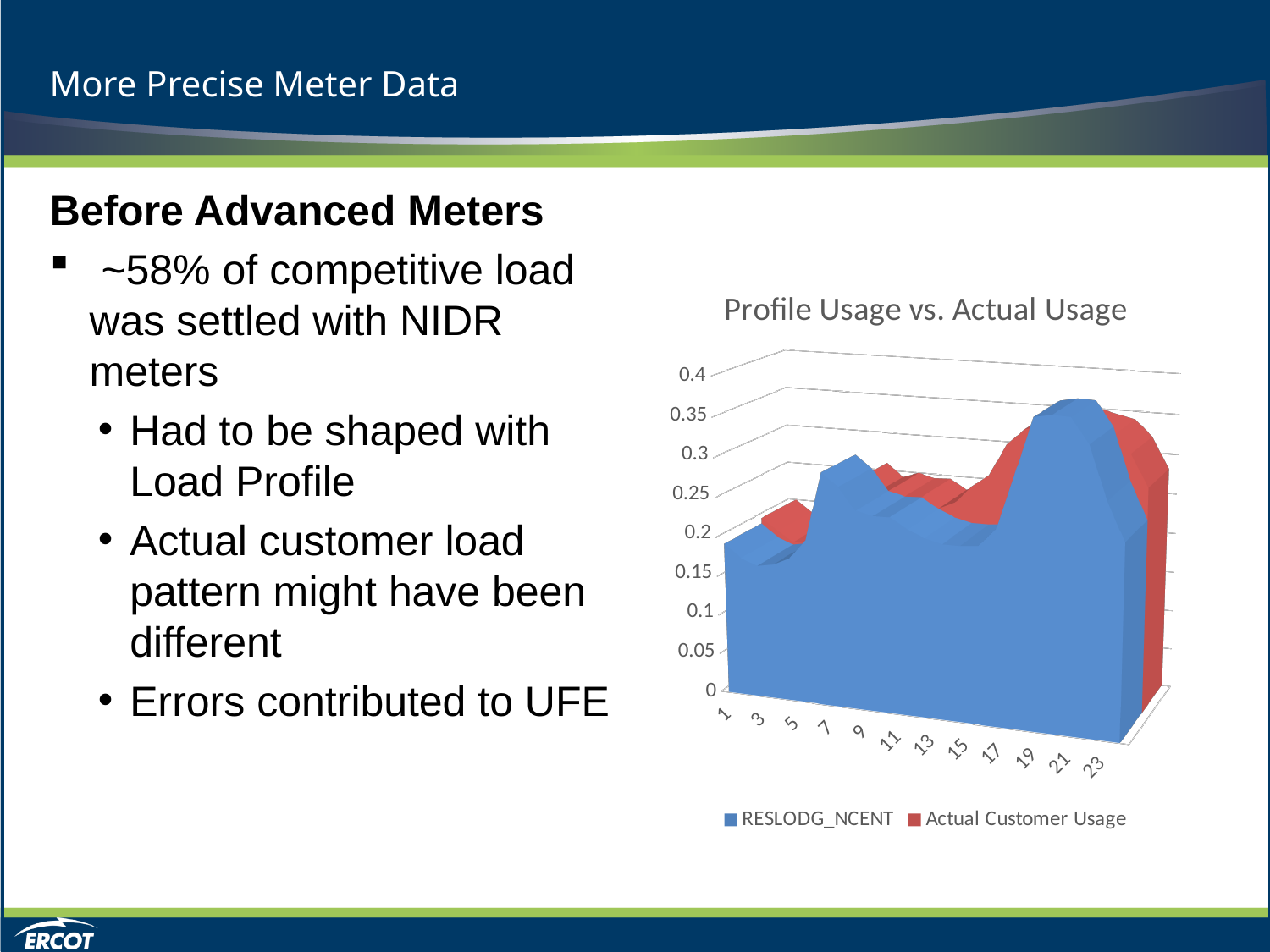
What is the highest value shown on the chart's vertical axis? 0.4 How many labels are printed along the chart's horizontal axis? 12 What are the two series named in the chart legend? RESLODG_NCENT and Actual Customer Usage Is the value for RESLODG_NCENT at hour 1 greater or less than 0.4? less Which series is drawn in blue on the chart? RESLODG_NCENT What is the lowest value shown on the chart's vertical axis? 0 What is the title of the chart on the slide? Profile Usage vs. Actual Usage What kind of chart is shown on the slide? 3D area chart How many series does the chart's legend list? 2 Does the RESLODG_NCENT series rise or fall between hour 17 and hour 21? rise Is the peak value of the RESLODG_NCENT series greater or less than 0.1? greater